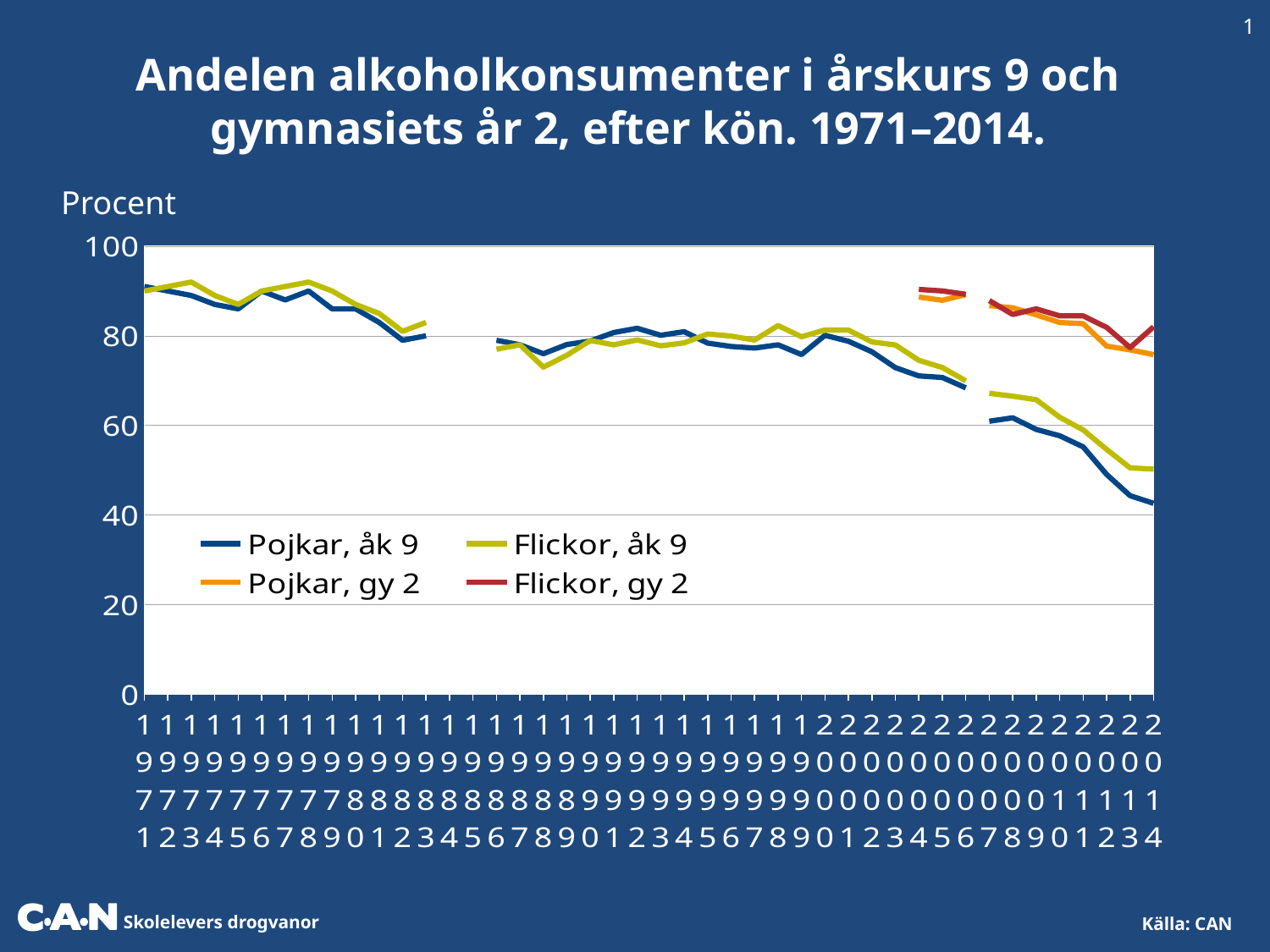
Is the value for Pojkar, åk 9 in 2014 greater or less than 60? less How many series does the legend list? 4 Which series has the highest value in 2014? Flickor, gy 2 What is the title of the chart? Andelen alkoholkonsumenter i årskurs 9 och gymnasiets år 2, efter kön. 1971–2014. What label is shown on the vertical axis? Procent How many years are shown along the x axis? 44 Does the Pojkar, åk 9 series rise or fall overall from 1971 to 2014? fall Is the value for Flickor, åk 9 in 2014 greater or less than 60? less In 2014, which is larger: Pojkar, åk 9 or Flickor, åk 9? Flickor, åk 9 What kind of chart is shown on the slide? line chart Is the value for Flickor, gy 2 in 2014 greater or less than 60? greater